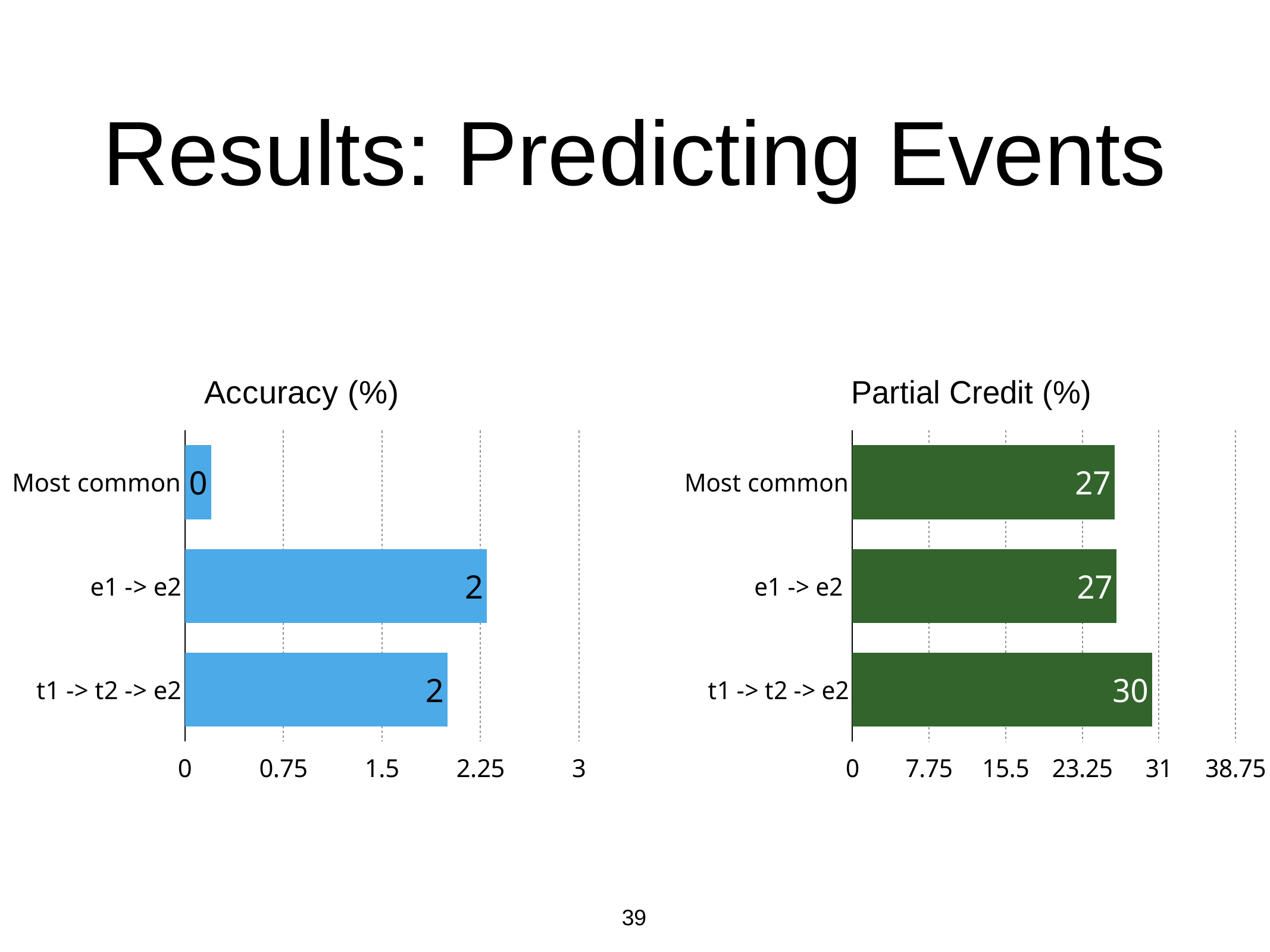
In the Partial Credit (%) chart, is the value for Most common greater or less than 23.25? greater In the Accuracy (%) chart, is the value for t1 -> t2 -> e2 greater or less than 2.25? less In the Partial Credit (%) chart, which category has the highest value? t1 -> t2 -> e2 In the Accuracy (%) chart, what is the value for Most common? 0 In the Partial Credit (%) chart, what is the value for Most common? 27 What kind of chart is the Partial Credit (%) chart? bar chart In the Partial Credit (%) chart, what is the difference between t1 -> t2 -> e2 and Most common? 3 How many categories are shown in the Accuracy (%) chart? 3 In the Accuracy (%) chart, which category has the lowest value? Most common In the Partial Credit (%) chart, what is the value for t1 -> t2 -> e2? 30 In the Accuracy (%) chart, what is the value for e1 -> e2? 2 In the Partial Credit (%) chart, which is larger, e1 -> e2 or t1 -> t2 -> e2? t1 -> t2 -> e2